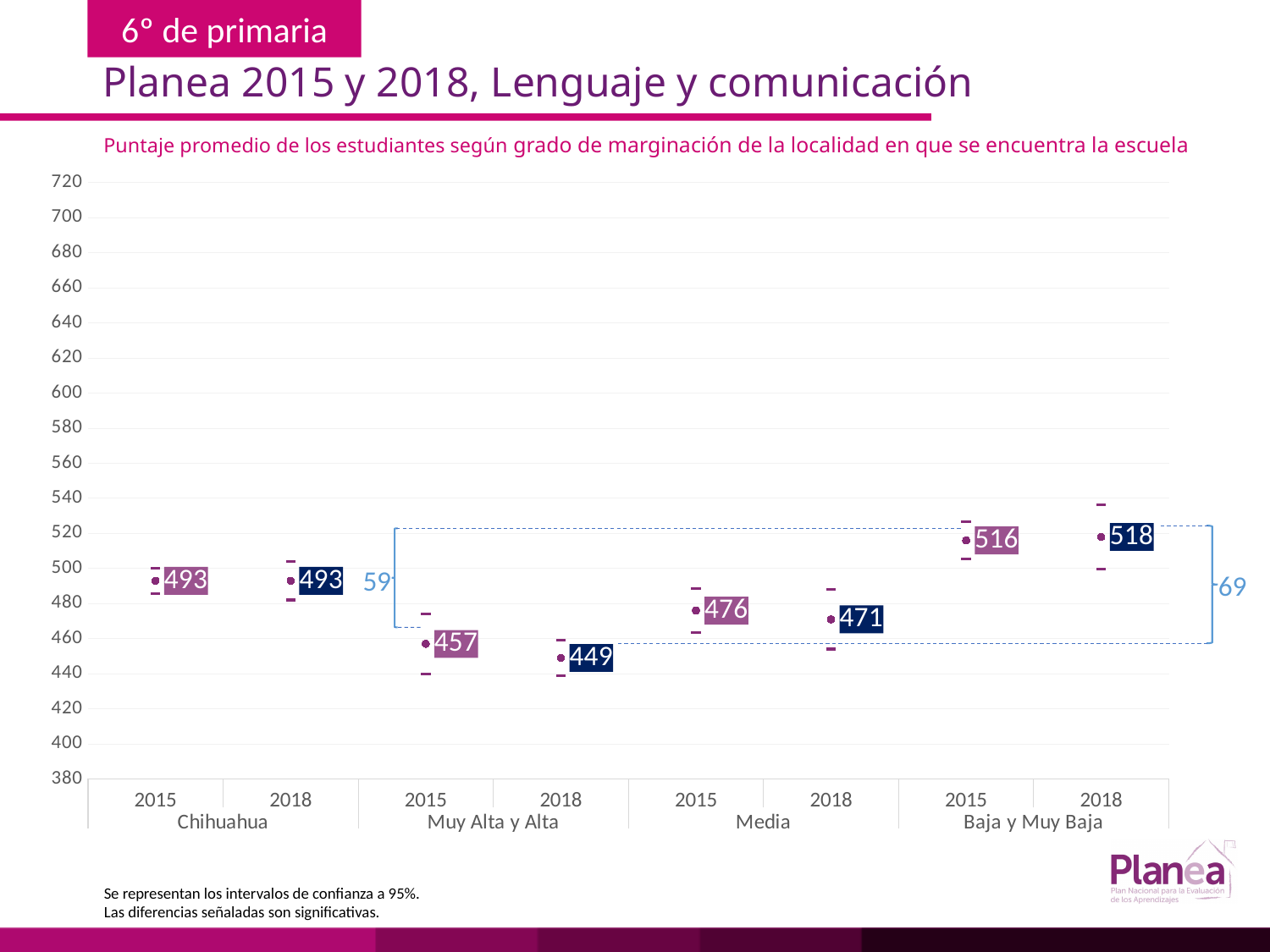
What is the difference between the 2018 values for Baja y Muy Baja and Muy Alta y Alta? 69 Which is larger, the 2015 value for Media or the 2015 value for Muy Alta y Alta? 2015 value for Media Which group and year has the lowest plotted value? Muy Alta y Alta, 2018 What is the difference between the 2015 and 2018 values for Media? 5 Which group and year has the highest plotted value? Baja y Muy Baja, 2018 What is the 2018 value for Muy Alta y Alta? 449 What is the 2018 value for Chihuahua? 493 How many marginación groups are shown on the x axis? 4 What is the subtitle of the chart? Puntaje promedio de los estudiantes según grado de marginación de la localidad en que se encuentra la escuela Is the 2015 value for Baja y Muy Baja greater or less than 500? greater What is the 2015 value for Media? 476 What is the 2015 value for Baja y Muy Baja? 516